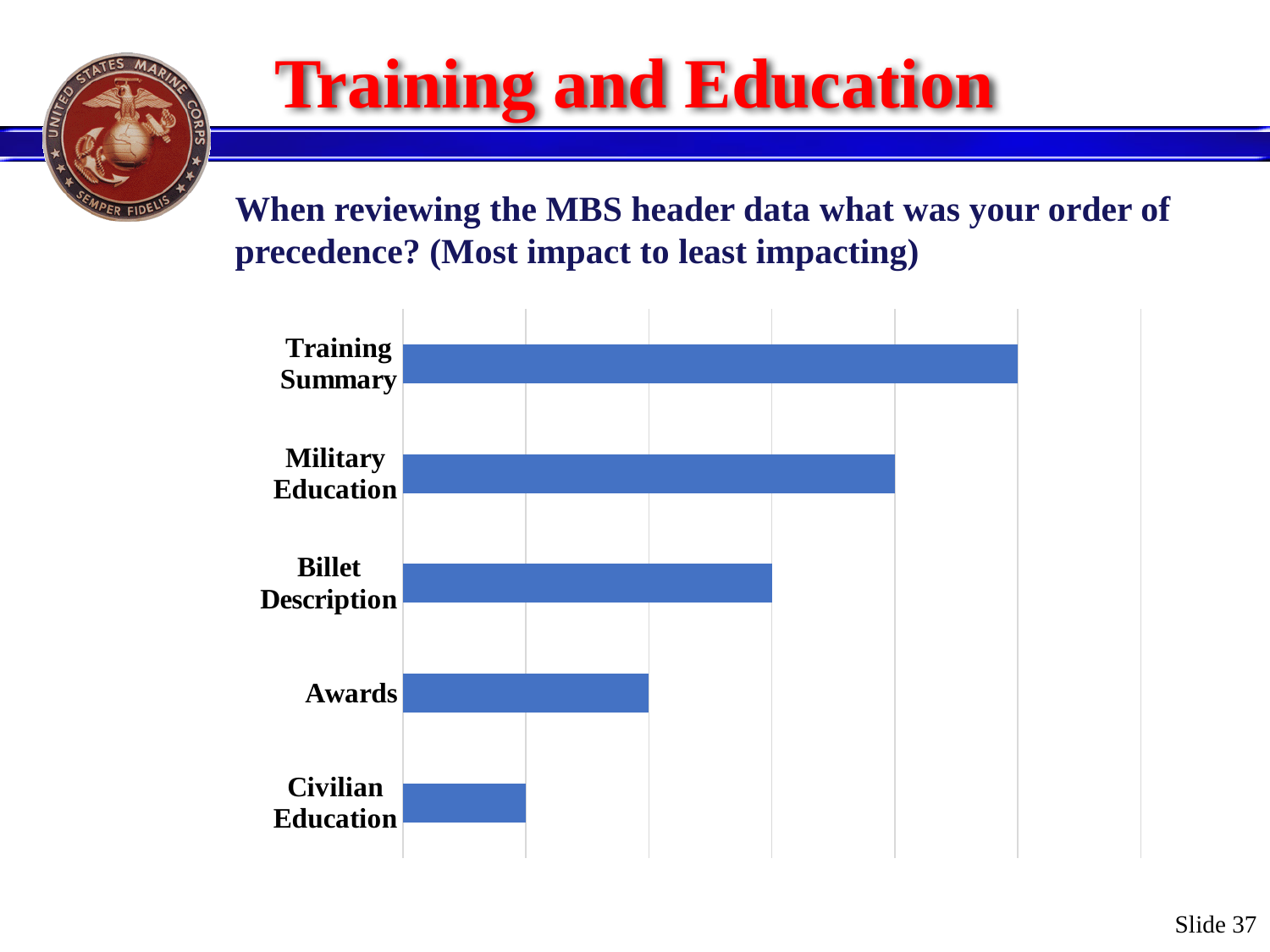
How many categories are plotted in the chart? 5 Which category is listed at the top of the chart? Training Summary What kind of chart is shown on the slide? bar chart Which category has the shortest bar in the chart? Civilian Education Which has the larger value, Training Summary or Military Education? Training Summary Which has the larger value, Military Education or Billet Description? Military Education Which category has the longest bar in the chart? Training Summary Which has the larger value, Billet Description or Awards? Billet Description What is the title of the slide containing the chart? Training and Education Do the bar lengths increase or decrease going from the top category to the bottom category? decrease